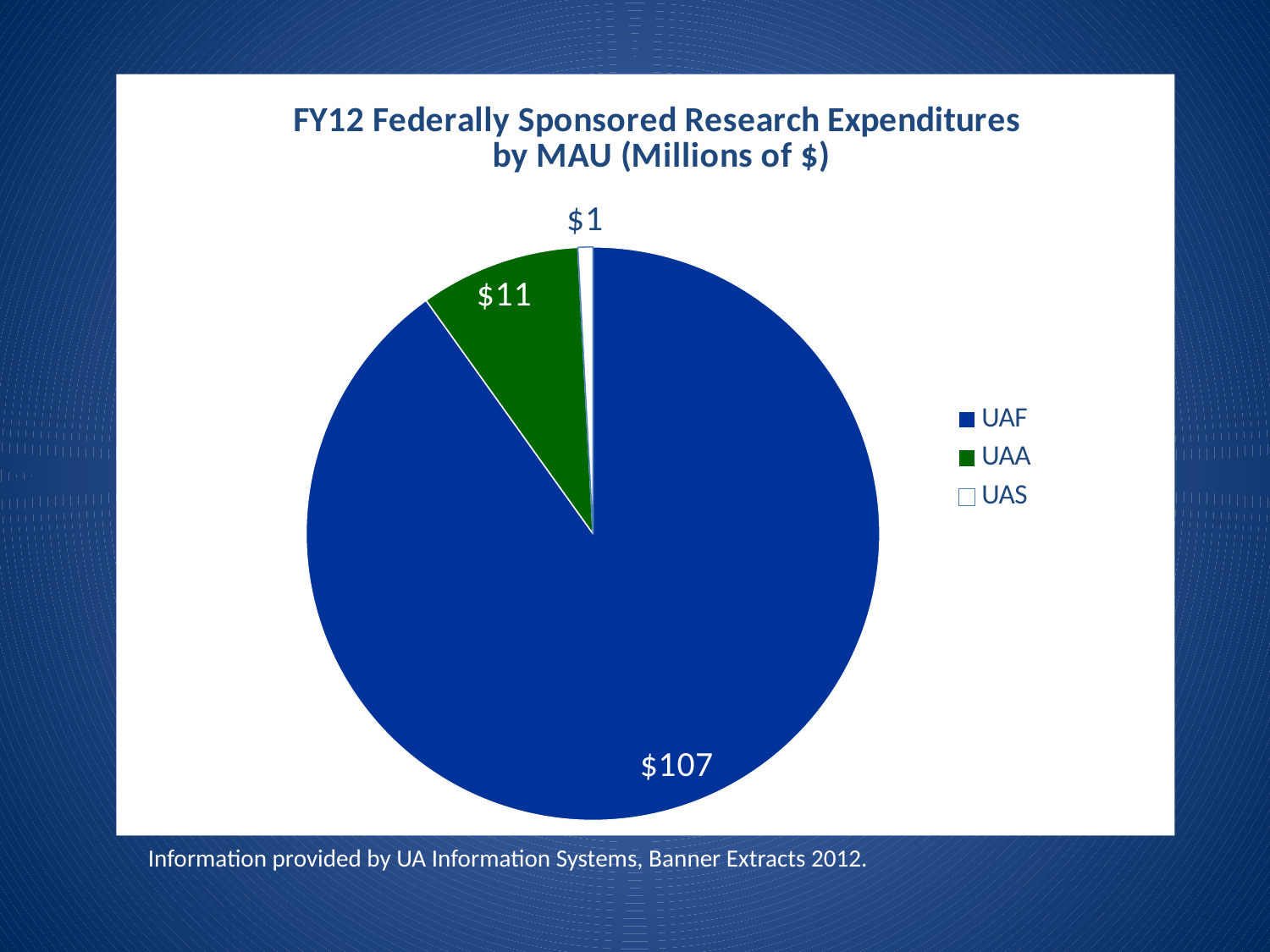
Which MAU has the lowest federally sponsored research expenditures? UAS What is the value for UAF? $107 What kind of chart is shown on the slide? Pie chart What is the value for UAS? $1 Which is larger, the value for UAA or the value for UAS? UAA What is the value for UAA? $11 What is the difference between the values for UAF and UAA? $96 What colour is the UAA slice? Green How many slices does the pie chart have? 3 What is the difference between the values for UAA and UAS? $10 What is the title of the chart? FY12 Federally Sponsored Research Expenditures by MAU (Millions of $) Which MAU has the highest federally sponsored research expenditures? UAF